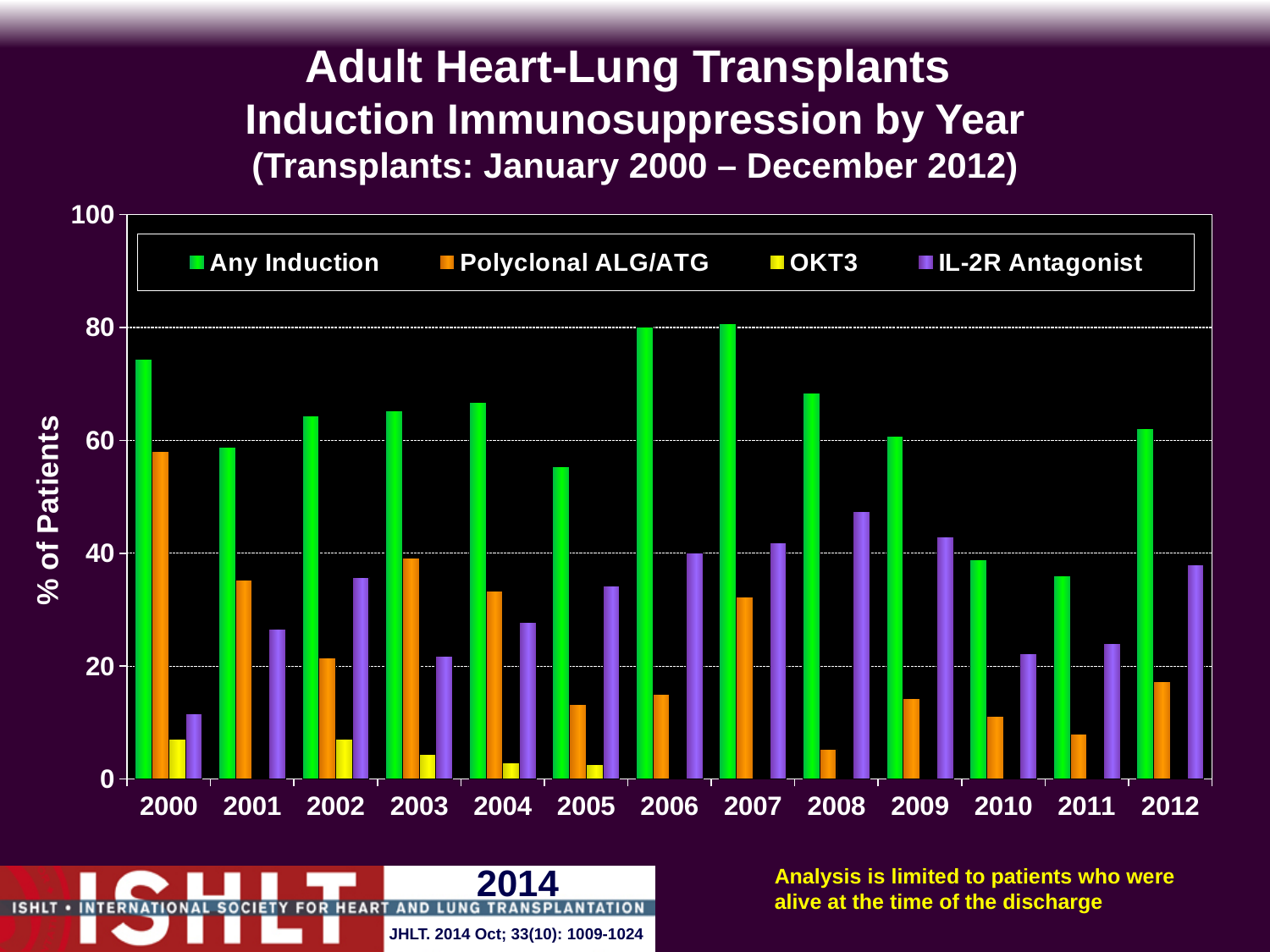
Does the Polyclonal ALG/ATG series generally rise or fall from 2000 to 2012? Fall Is the Any Induction value for 2000 greater or less than 60? greater In which year is the Polyclonal ALG/ATG value highest? 2000 In which year is the IL-2R Antagonist value lowest? 2000 Which is larger in 2003, the Polyclonal ALG/ATG value or the IL-2R Antagonist value? Polyclonal ALG/ATG In which year is the Polyclonal ALG/ATG value lowest? 2008 How many series does the legend list? 4 What kind of chart is shown on the slide? Bar chart How many years are shown along the x axis? 13 Is the Polyclonal ALG/ATG value for 2008 greater or less than 20? less What is the title of the y axis? % of Patients In which year is the IL-2R Antagonist value highest? 2008